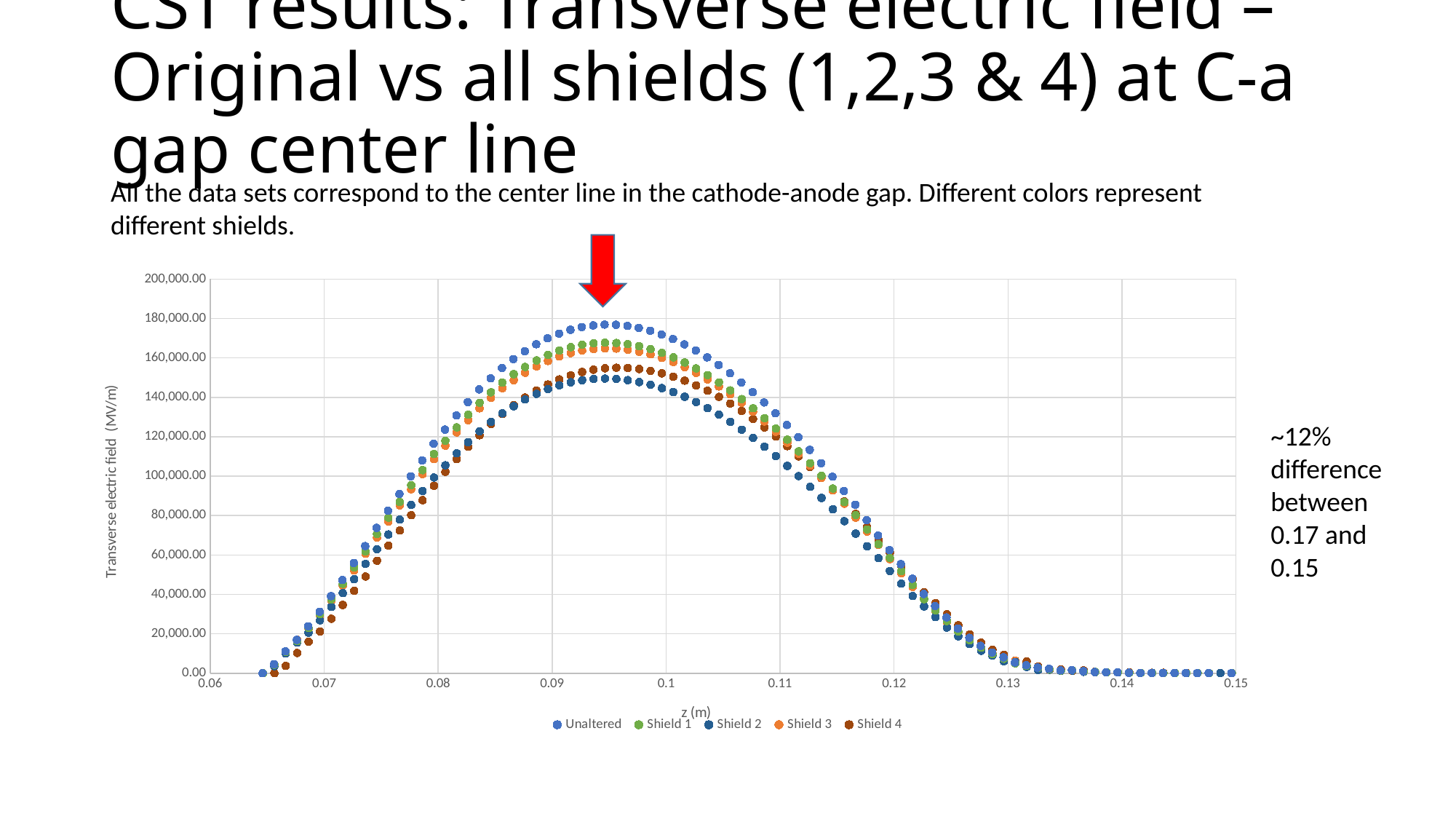
What is the label of the vertical axis? Transverse electric field (MV/m) What are the legend entries of the chart? Unaltered, Shield 1, Shield 2, Shield 3, Shield 4 Which series has the lowest peak value of transverse electric field? Shield 2 Which series reaches the highest peak value of transverse electric field? Unaltered At the peak near z = 0.095 m, which series has the larger value, Unaltered or Shield 2? Unaltered Is the peak value of the Shield 4 series greater or less than 160,000.00? less How many series does the chart legend list? 5 How do the values change as z increases from 0.06 m to 0.15 m? rise then fall What kind of chart is shown on the slide? scatter chart Is the peak value of the Shield 2 series greater or less than 160,000.00? less Is the peak value of the Unaltered series greater or less than 180,000.00? less